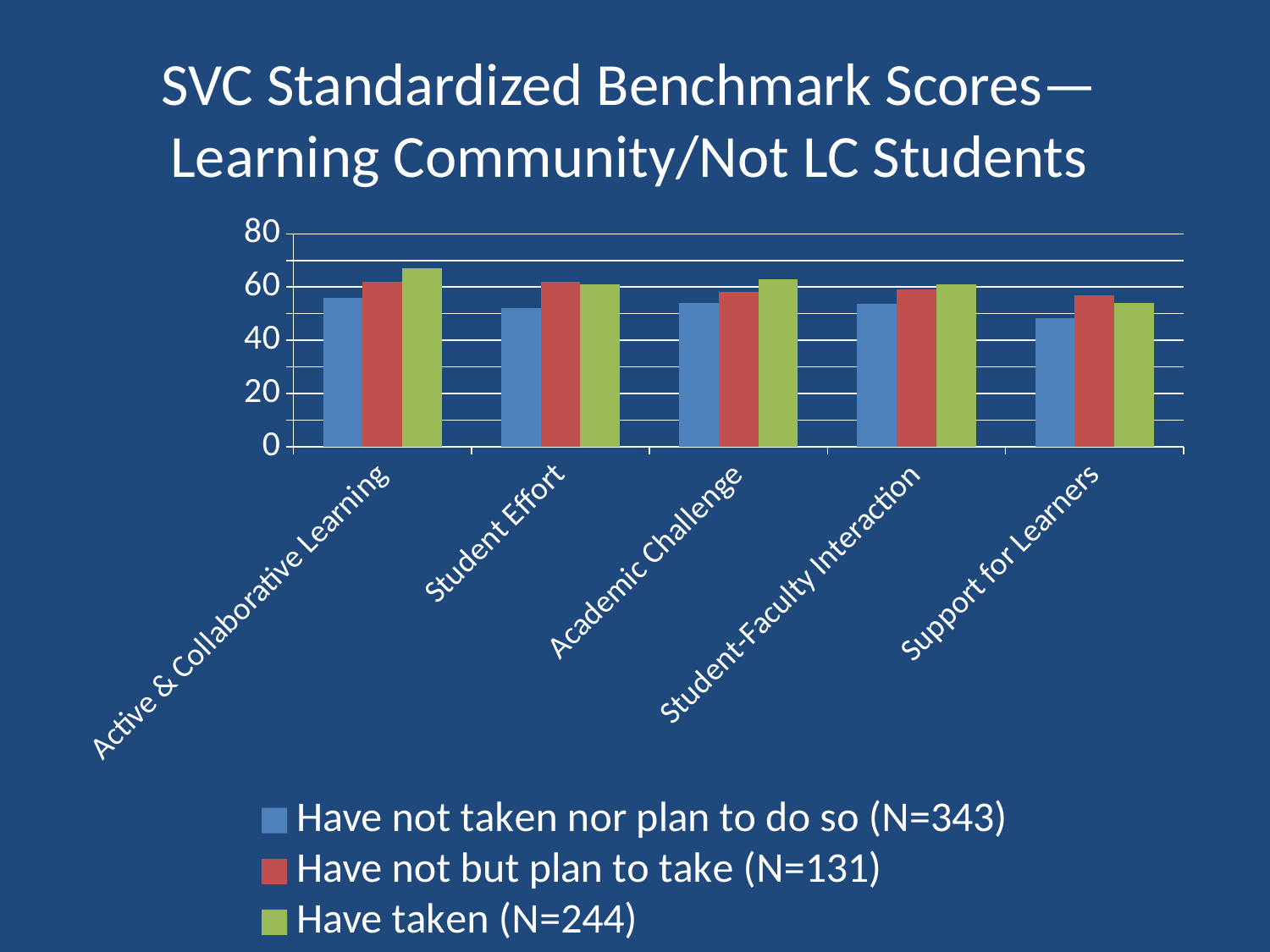
Is the value for Have not taken nor plan to do so (N=343) in Support for Learners greater or less than 60? less What kind of chart is shown on the slide? bar chart What colour represents the Have taken (N=244) series? green In Support for Learners, which is larger: the value for Have not but plan to take (N=131) or for Have not taken nor plan to do so (N=343)? Have not but plan to take (N=131) Which category has the highest value for the Have taken (N=244) series? Active & Collaborative Learning How many benchmark categories are shown on the x axis? 5 Is the value for Have not taken nor plan to do so (N=343) in Active & Collaborative Learning greater or less than 60? less How many series does the legend list? 3 Is the value for Have taken (N=244) in Active & Collaborative Learning greater or less than 60? greater Which category has the lowest value for the Have not taken nor plan to do so (N=343) series? Support for Learners What is the N shown in the legend for the Have taken series? 244 In Active & Collaborative Learning, which is larger: the value for Have taken (N=244) or for Have not taken nor plan to do so (N=343)? Have taken (N=244)